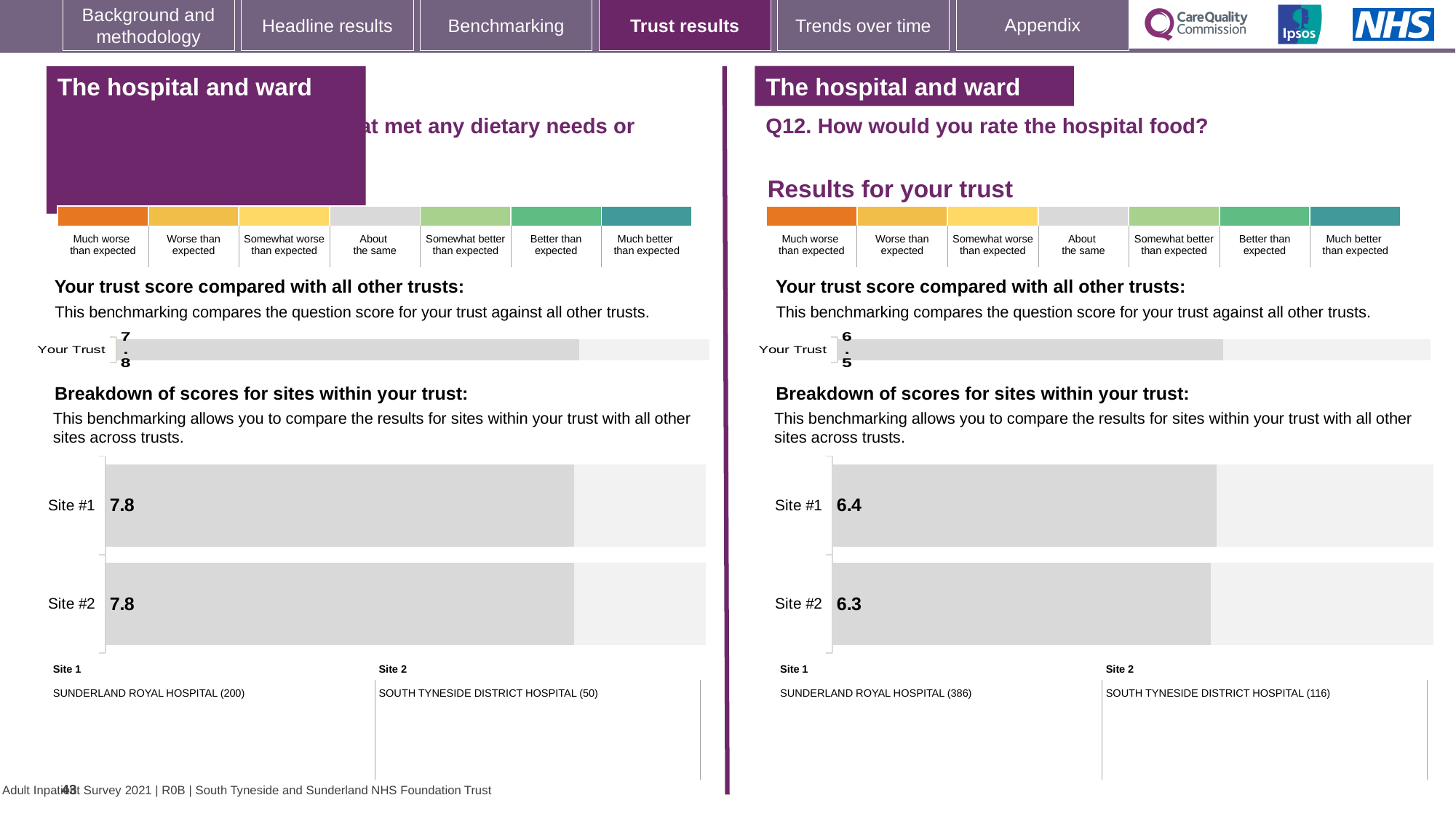
On the right-hand panel (Q12), what is the difference between the Site #1 and Site #2 scores? 0.1 On the left-hand panel, what is the score for Site #1 in the breakdown of scores for sites chart? 7.8 What type of chart is used for the breakdown of scores for sites on the right-hand panel (Q12)? Bar chart On the right-hand panel (Q12), which hospital is listed as Site 1 below the chart? SUNDERLAND ROYAL HOSPITAL (386) Is the Site #1 score on the left-hand panel larger or smaller than the Site #1 score on the right-hand panel (Q12)? Larger On the left-hand panel, what is the 'Your Trust' score in the trust score chart? 7.8 On the right-hand panel (Q12. How would you rate the hospital food?), what is the 'Your Trust' score in the trust score chart? 6.5 On the right-hand panel (Q12), how many sites are shown in the breakdown of scores for sites chart? 2 On the right-hand panel (Q12), which site has the higher score in the breakdown of scores for sites chart? Site #1 On the right-hand panel (Q12. How would you rate the hospital food?), what is the score for Site #2 in the breakdown of scores for sites chart? 6.3 On the right-hand panel (Q12. How would you rate the hospital food?), what is the score for Site #1 in the breakdown of scores for sites chart? 6.4 On the left-hand panel, what is the score for Site #2 in the breakdown of scores for sites chart? 7.8